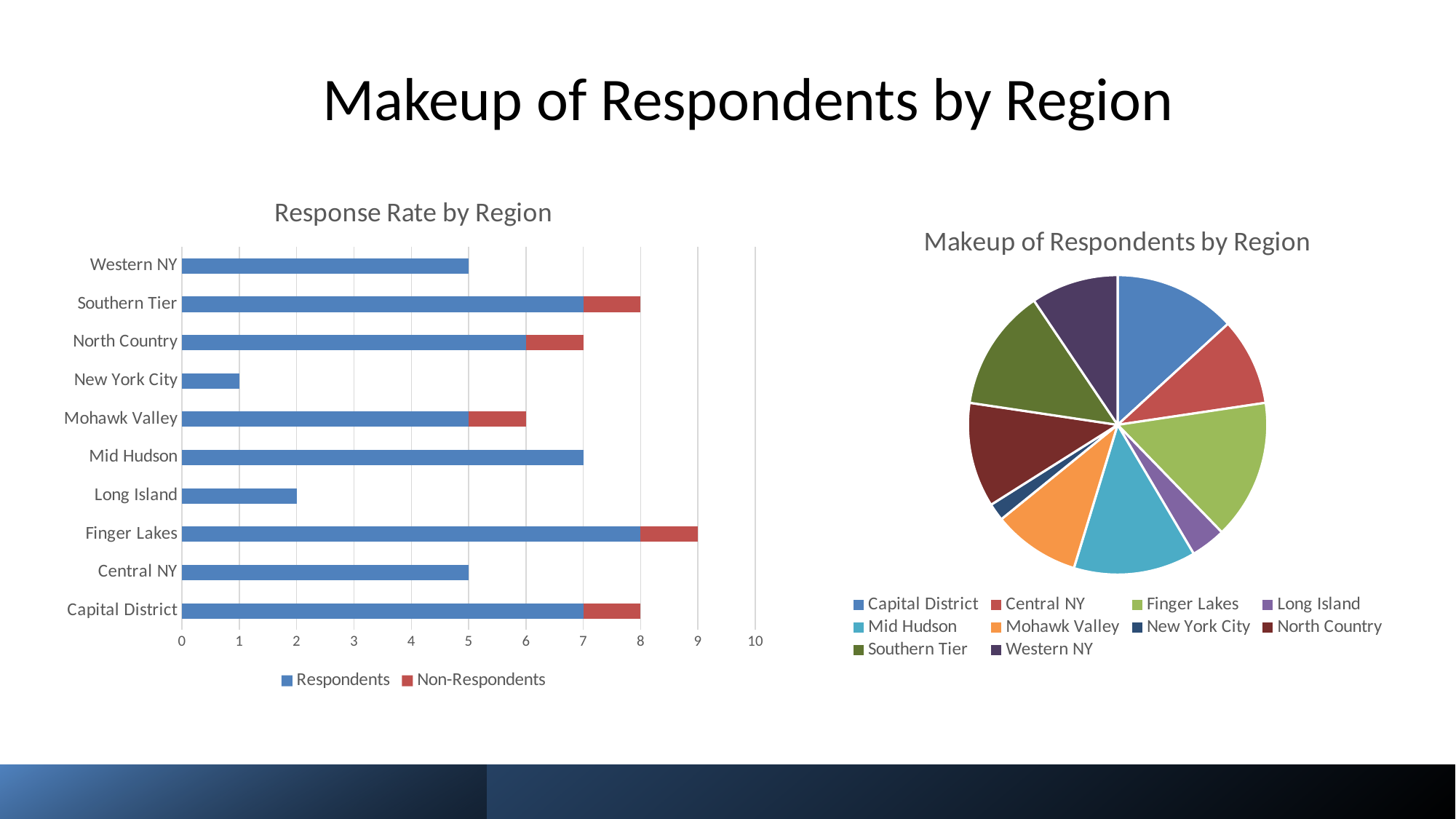
In the 'Response Rate by Region' chart, what is the Respondents value for New York City? 1 In the 'Response Rate by Region' chart, which region has the lowest Respondents value? New York City In the 'Response Rate by Region' chart, how many regions are shown on the vertical axis? 10 In the 'Response Rate by Region' chart, what is the Respondents value for Finger Lakes? 8 In the 'Response Rate by Region' chart, how many series does the legend list? 2 In the 'Response Rate by Region' chart, what is the difference between the Respondents values for Mid Hudson and Long Island? 5 What kind of chart is the 'Response Rate by Region' chart on the left? Bar chart In the 'Makeup of Respondents by Region' pie chart, which region has the smallest slice? New York City What kind of chart is the 'Makeup of Respondents by Region' chart on the right? Pie chart In the 'Response Rate by Region' chart, which is larger: the Respondents value for Western NY or for Long Island? Western NY In the 'Response Rate by Region' chart, which region has the highest Respondents value? Finger Lakes In the 'Response Rate by Region' chart, what is the total of the stacked bar for Southern Tier? 8